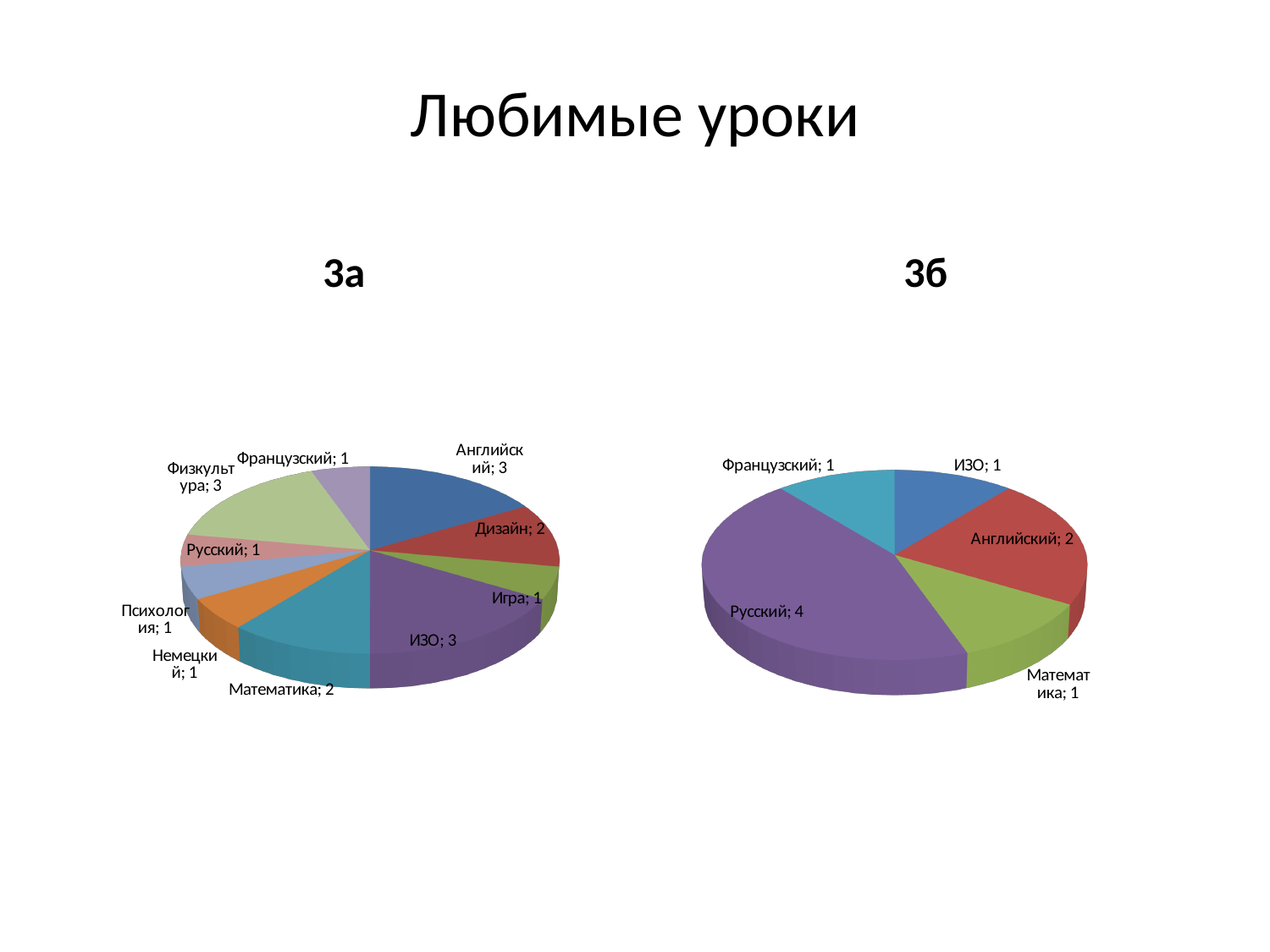
In the 3а chart, what is the value for Физкультура? 3 In the 3а chart, what is the difference between the values for Английский and Игра? 2 In the 3б chart, what is the value for Английский? 2 In the 3б chart, which category has the highest value? Русский In the 3б chart, which is larger, the value for Английский or the value for ИЗО? Английский How many categories are shown in the 3а chart? 10 How many categories are shown in the 3б chart? 5 In the 3а chart, what is the value for Математика? 2 In the 3б chart, what is the difference between the values for Русский and Математика? 3 In the 3а chart, which is larger, the value for Физкультура or the value for Дизайн? Физкультура In the 3б chart, what is the value for Русский? 4 What kind of chart is the 3б chart? Pie chart